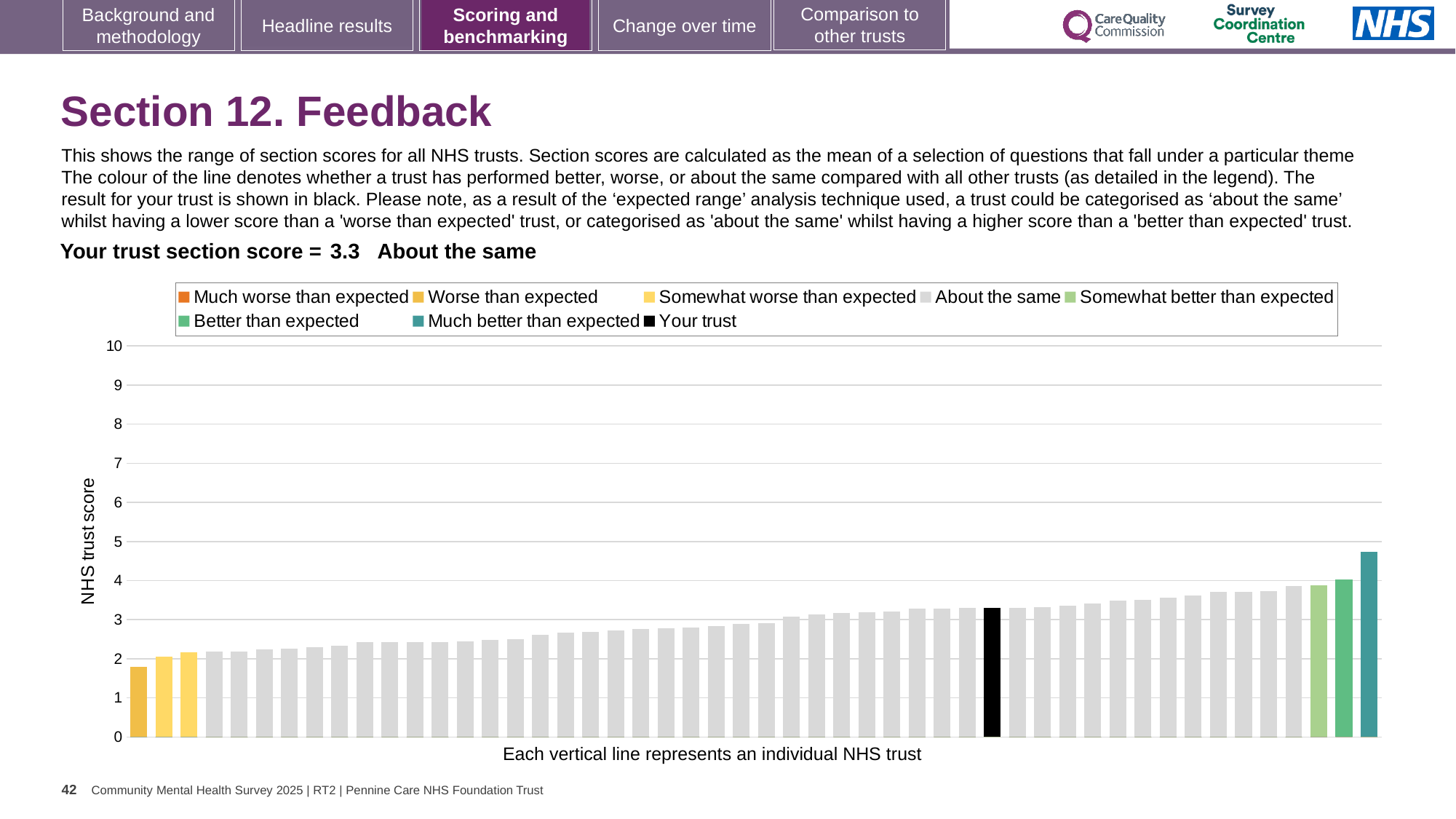
What is the trust's section score shown on the slide? 3.3 Is the value of the black 'Your trust' bar greater or less than 4? less Is the value of the tallest bar greater or less than 4? greater Do the bar values rise or fall from left to right along the x axis? rise How many entries does the chart legend list? 8 Is the value of the tallest bar greater or less than 5? less What is the label on the vertical axis of the chart? NHS trust score What colour is the bar representing 'Your trust'? black What kind of chart is shown on the slide? bar chart Which category is the trust's section score placed in? About the same